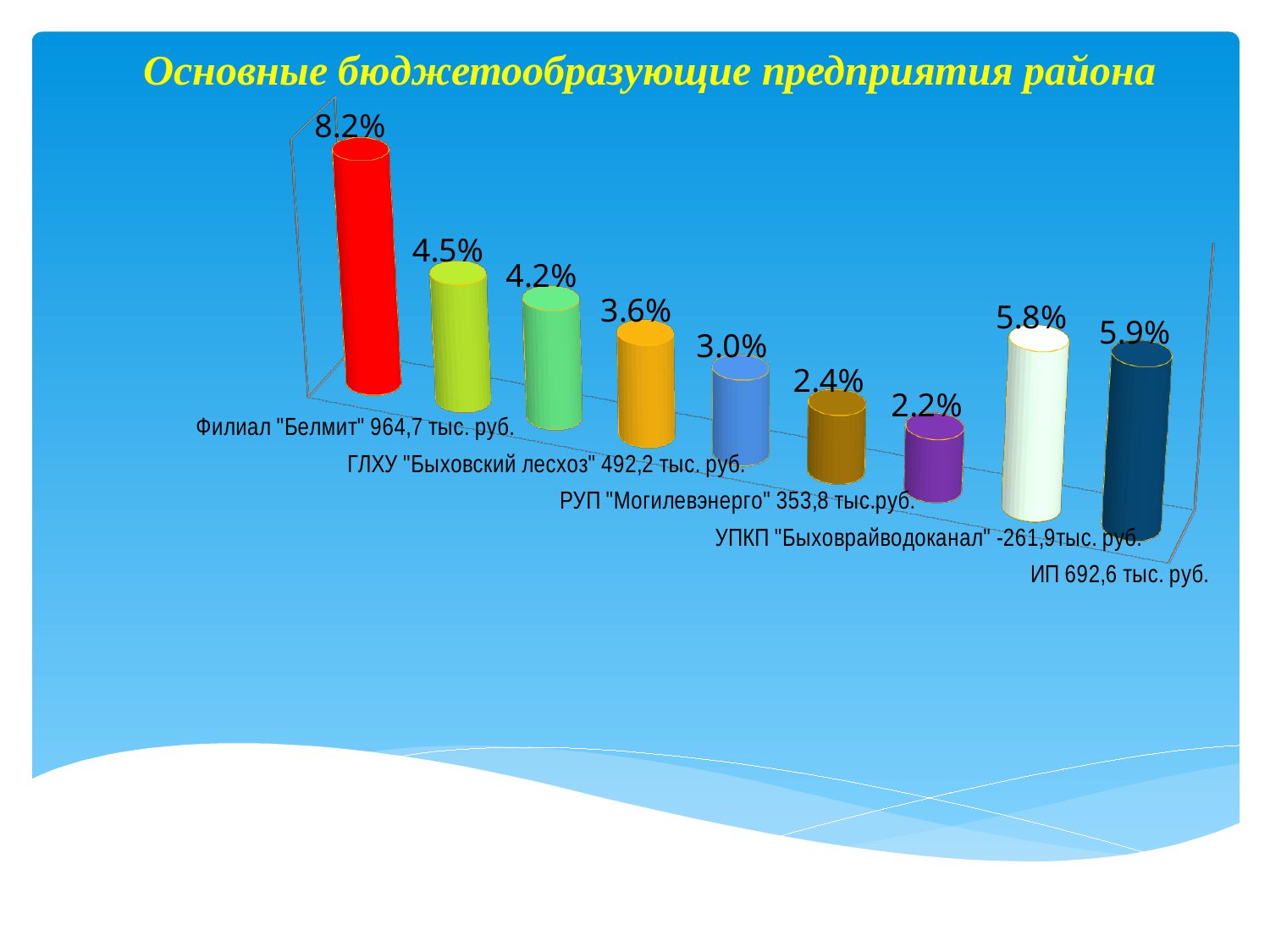
What value is labelled on the red bar (the first bar from the left)? 8.2% What value is labelled on the last bar on the right (dark blue)? 5.9% What is the highest value shown in the chart? 8.2% What is the title of the chart on the slide? Основные бюджетообразующие предприятия района From the first bar on the left to the seventh bar (purple), do the values rise or fall? fall What is the difference between the first bar (8.2%) and the second bar (4.5%)? 3.7% What is the lowest value shown in the chart? 2.2% Which is larger, the value on the red bar or the value on the yellow-green bar? the red bar How many bars are plotted in the chart? 9 What value is labelled on the purple bar? 2.2% What value is labelled on the white bar? 5.8% What kind of chart is shown on the slide? bar chart